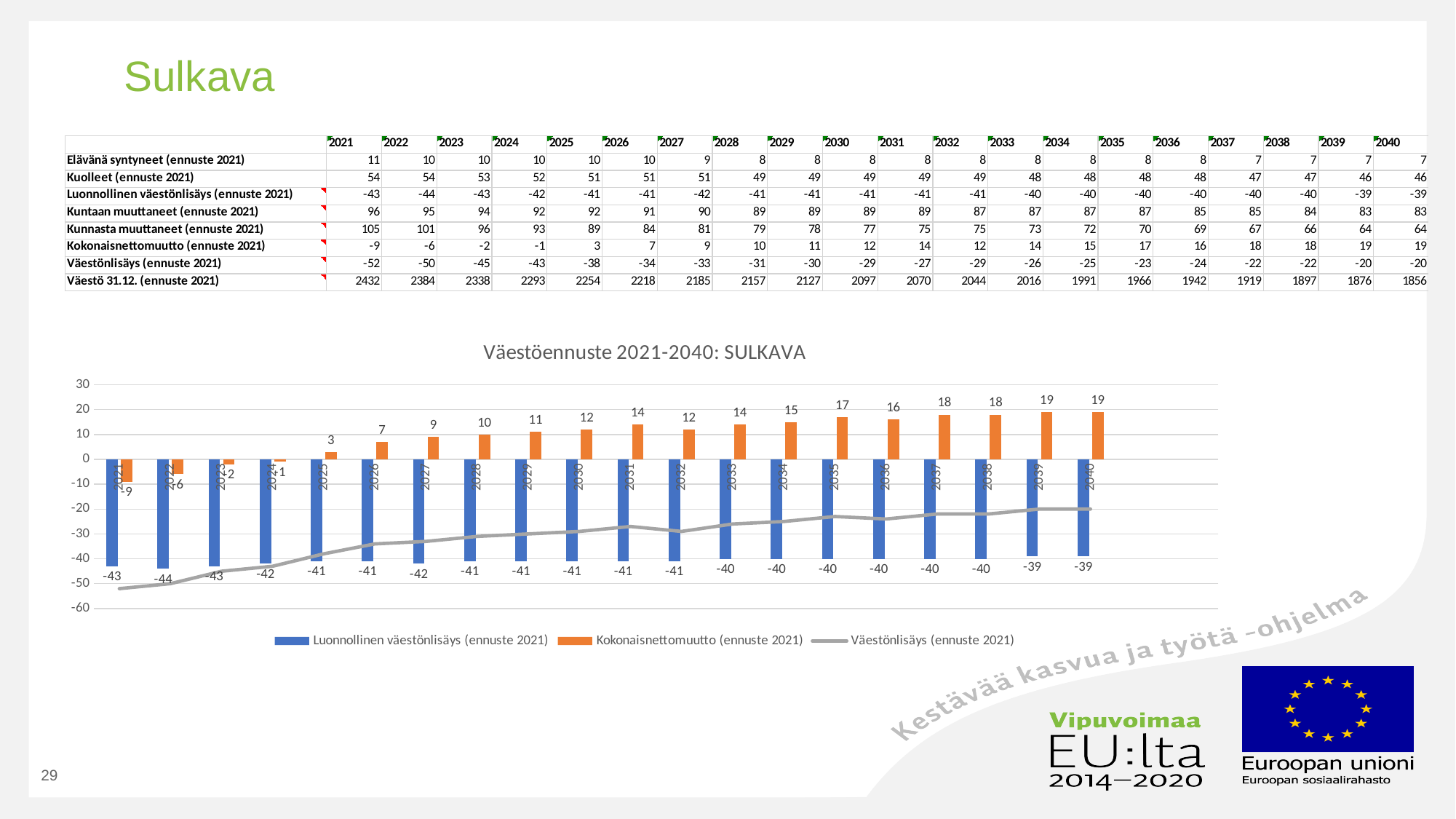
In which year is Luonnollinen väestönlisäys (ennuste 2021) lowest in the chart? 2022 What is the title of the chart? Väestöennuste 2021-2040: SULKAVA How many years are shown on the x axis of the chart? 20 What is the value of Luonnollinen väestönlisäys (ennuste 2021) for 2022 in the chart? -44 How many series does the chart legend list? 3 What is the value of Kokonaisnettomuutto (ennuste 2021) for 2040 in the chart? 19 What is the difference between the Kokonaisnettomuutto values for 2035 and 2030? 5 Does Kokonaisnettomuutto (ennuste 2021) generally rise or fall from 2021 to 2040? rise In which year is Kokonaisnettomuutto (ennuste 2021) lowest in the chart? 2021 Is the Väestönlisäys (ennuste 2021) line value for 2021 greater or less than -50? less Which year has the larger Kokonaisnettomuutto value, 2031 or 2032? 2031 What is the value of Kokonaisnettomuutto (ennuste 2021) for 2025 in the chart? 3